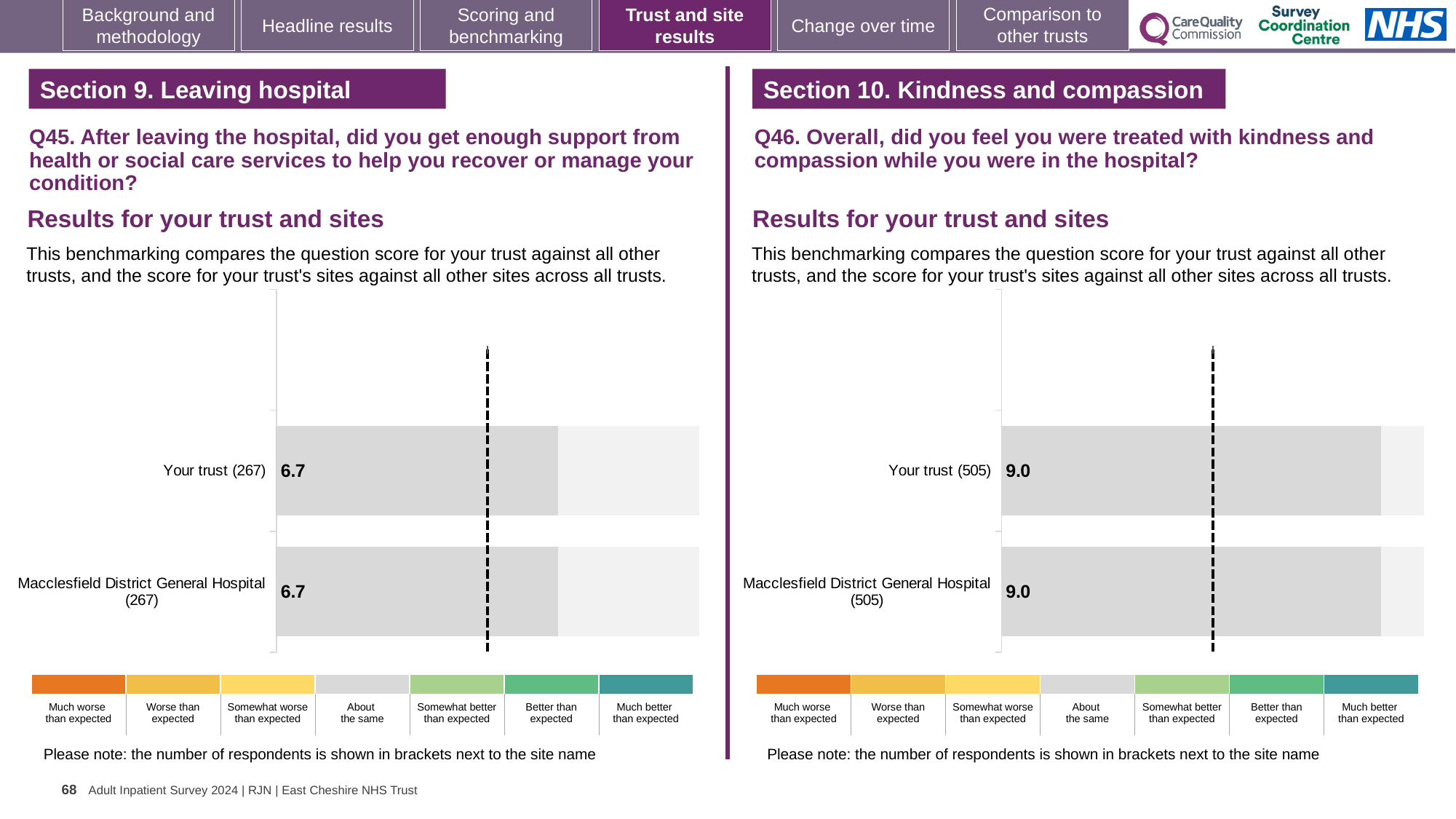
How many bars are plotted on the Q45 chart (left)? 2 On the Q45 chart (left), what is the difference between the score for Your trust and the score for Macclesfield District General Hospital? 0.0 On the Q46 chart (right), what is the difference between the score for Your trust and the score for Macclesfield District General Hospital? 0.0 On the Q45 chart (left), how many respondents are shown in brackets next to Macclesfield District General Hospital? 267 On the Q46 chart (right), what is the score for Macclesfield District General Hospital? 9.0 On the Q46 chart (right), what is the score for Your trust? 9.0 On the Q46 chart (right), how many respondents are shown in brackets next to Your trust? 505 How many bars are plotted on the Q46 chart (right)? 2 On the Q45 chart (left), what is the score for Your trust? 6.7 On the Q45 chart (left), what is the score for Macclesfield District General Hospital? 6.7 What kind of chart is used for the Q46 results on the right? Bar chart